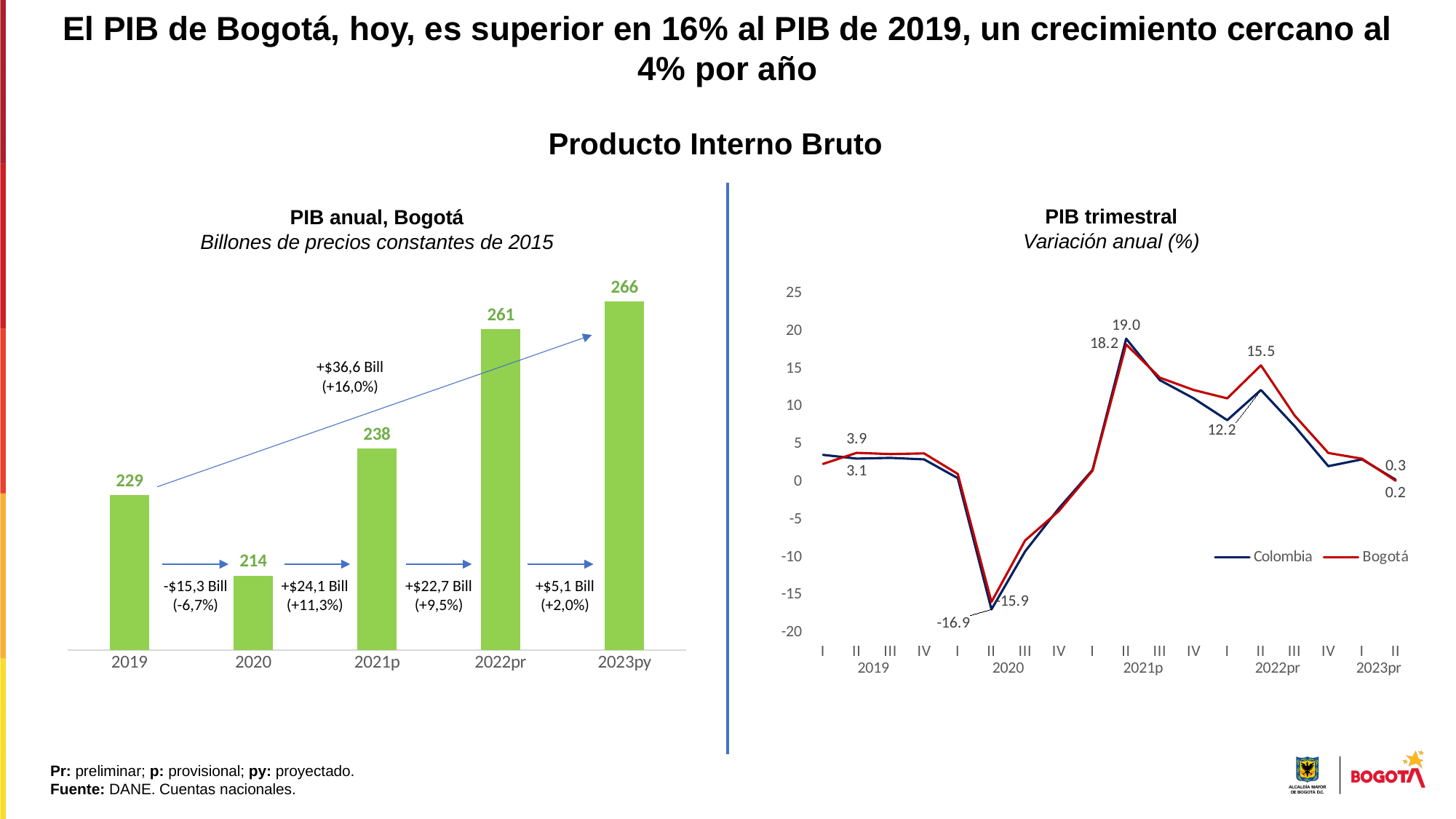
In the 'PIB trimestral' chart, what is the highest labelled value for Bogotá? 18.2 In the 'PIB anual, Bogotá' chart, how many years are shown on the x axis? 5 What kind of chart is the 'PIB trimestral' chart? Line chart In the 'PIB anual, Bogotá' chart, what is the value for 2022pr? 261 In the 'PIB anual, Bogotá' chart, which year has the highest value? 2023py In the 'PIB anual, Bogotá' chart, what is the value for 2019? 229 In the 'PIB anual, Bogotá' chart, what change is annotated between 2020 and 2021p? +$24,1 Bill (+11,3%) In the 'PIB anual, Bogotá' chart, what is the difference between the values for 2023py and 2019? 37 In the 'PIB anual, Bogotá' chart, which year has the lowest value? 2020 In the 'PIB trimestral' chart, what is the lowest labelled value for Colombia? -16.9 What kind of chart is the 'PIB anual, Bogotá' chart? Bar chart How many series does the legend of the 'PIB trimestral' chart list? 2